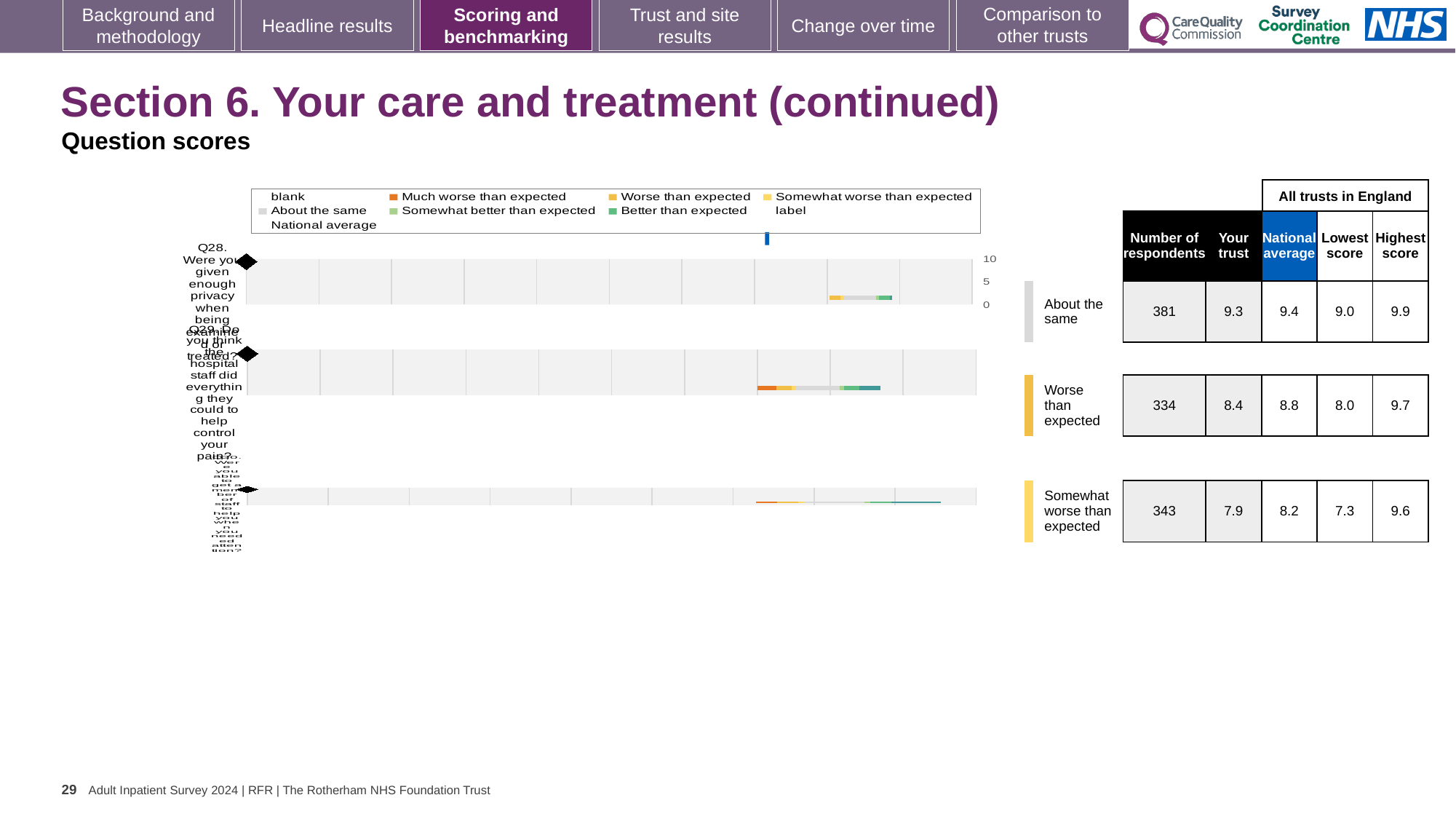
What is the number of respondents for Q28? 381 Which question has the highest 'Your trust' score? Q28 Which benchmark category is Q28 placed in? About the same Which question has the lowest 'Your trust' score? Q30 What kind of chart is shown on the slide? bar chart What is the national average score for Q30? 8.2 What is the lowest score across all trusts in England for Q30? 7.3 How many questions (Q28, Q29, Q30) are plotted in the chart? 3 How many entries does the chart legend list? 9 What is the 'Your trust' score for Q29? 8.4 What is the difference between the highest score and the lowest score for Q29? 1.7 For Q29, which is larger: the 'Your trust' score or the national average? National average